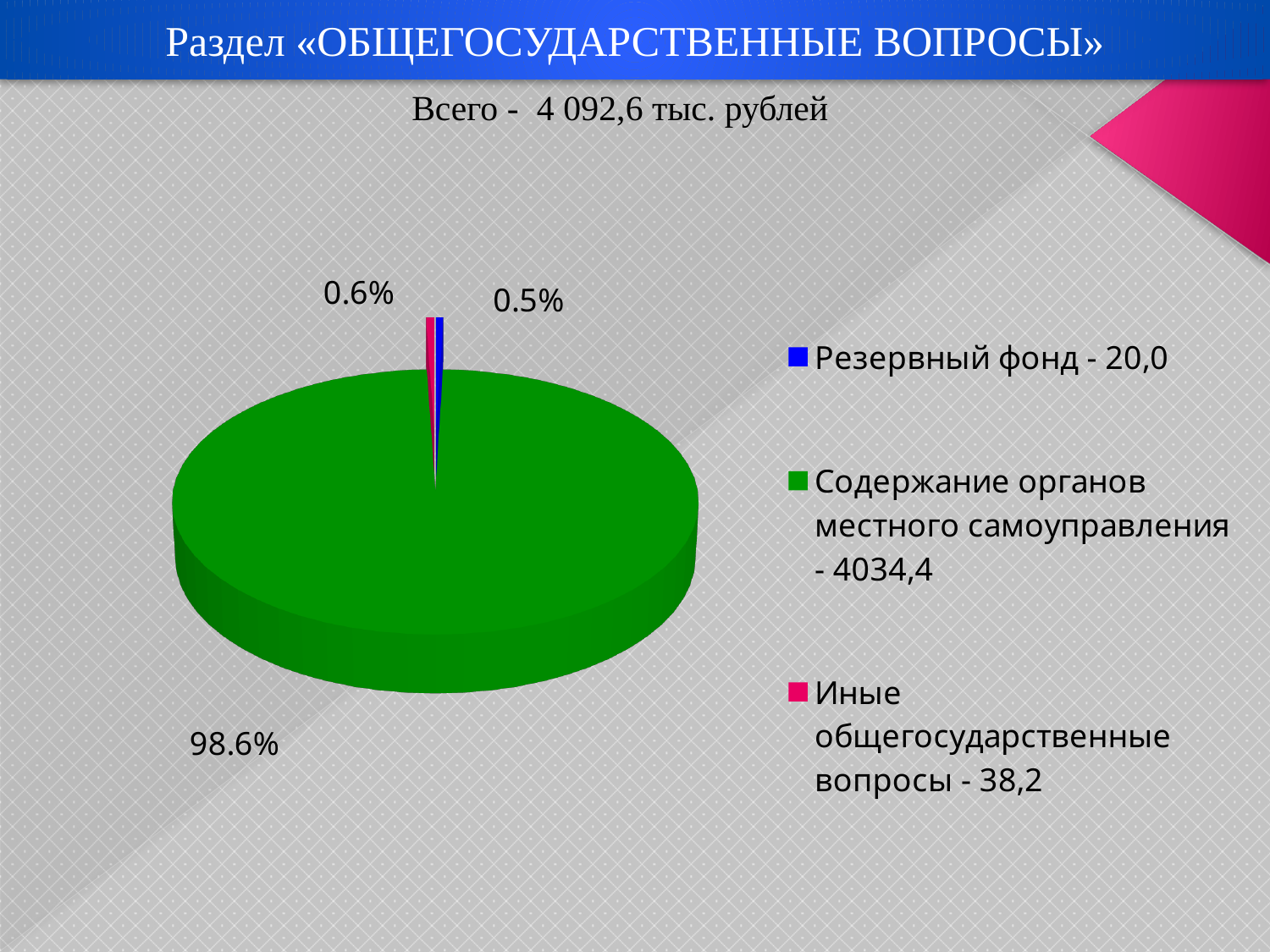
How many entries does the legend list? 3 What value is given for Резервный фонд in the legend? 20,0 What is the difference between the values for Иные общегосударственные вопросы and Резервный фонд? 18,2 What value is given for Содержание органов местного самоуправления in the legend? 4034,4 What kind of chart is shown on the slide? pie chart How many slices does the pie chart have? 3 What share of the pie does Резервный фонд take? 0.5% What total amount is stated above the chart? 4 092,6 тыс. рублей Which category has the largest slice of the pie? Содержание органов местного самоуправления What share of the pie does Содержание органов местного самоуправления take? 98.6% What value is given for Иные общегосударственные вопросы in the legend? 38,2 Which category has the smallest slice of the pie? Резервный фонд